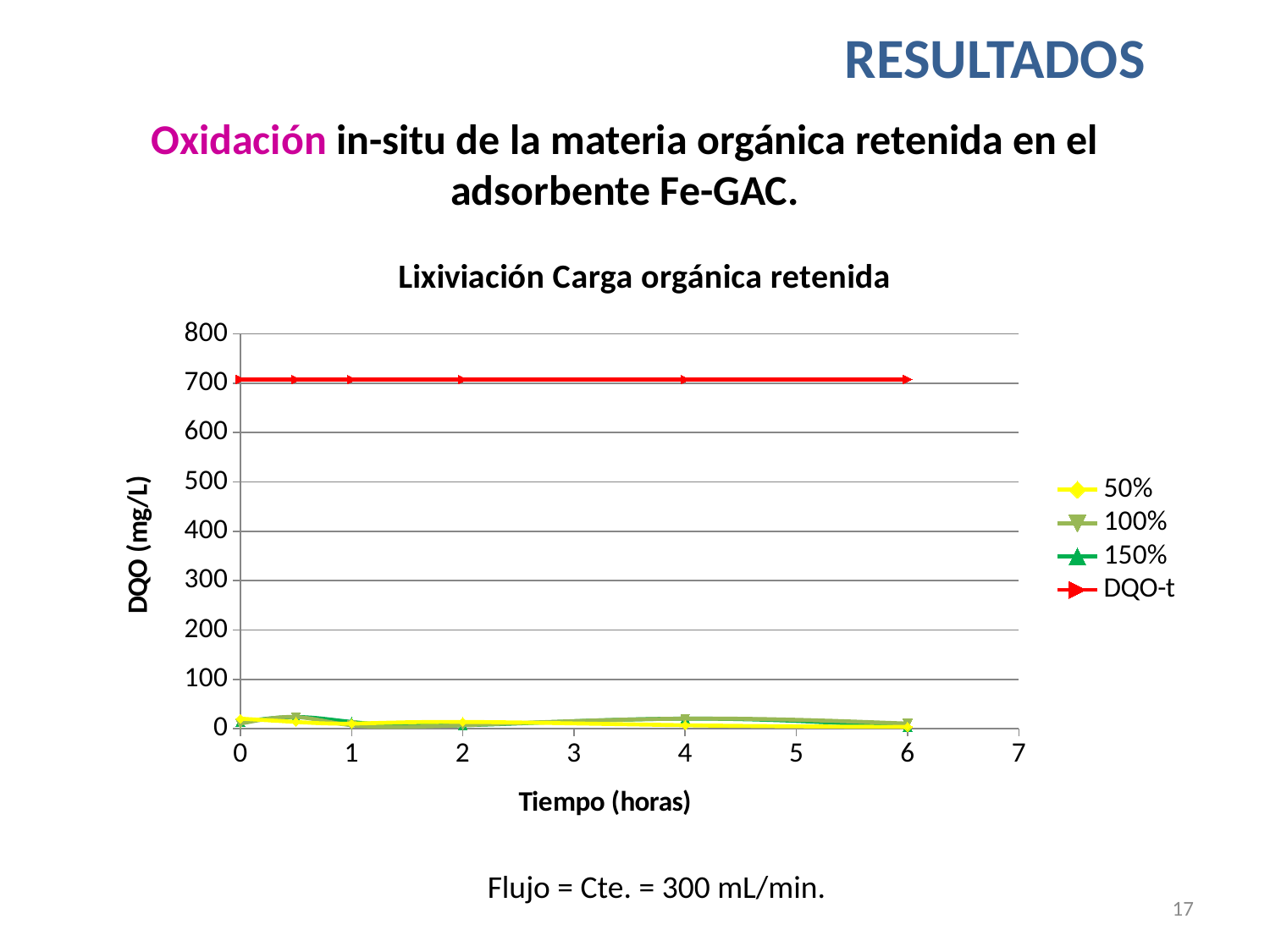
Is the value of the DQO-t series at 0 hours greater or less than 800? less What is the label of the y axis? DQO (mg/L) Is the value of the DQO-t series at 4 hours greater or less than 600? greater Is the value of the 100% series at 6 hours greater or less than 100? less How many data points are plotted for the DQO-t series? 6 What kind of chart is shown on the slide? line chart How many series does the legend list? 4 Does the DQO-t series rise, fall, or stay flat as time increases from 0 to 6 hours? stays flat At 4 hours, which is larger: the DQO-t value or the 150% value? DQO-t Which series has the highest values across the whole time range? DQO-t What is the title of the chart? Lixiviación Carga orgánica retenida